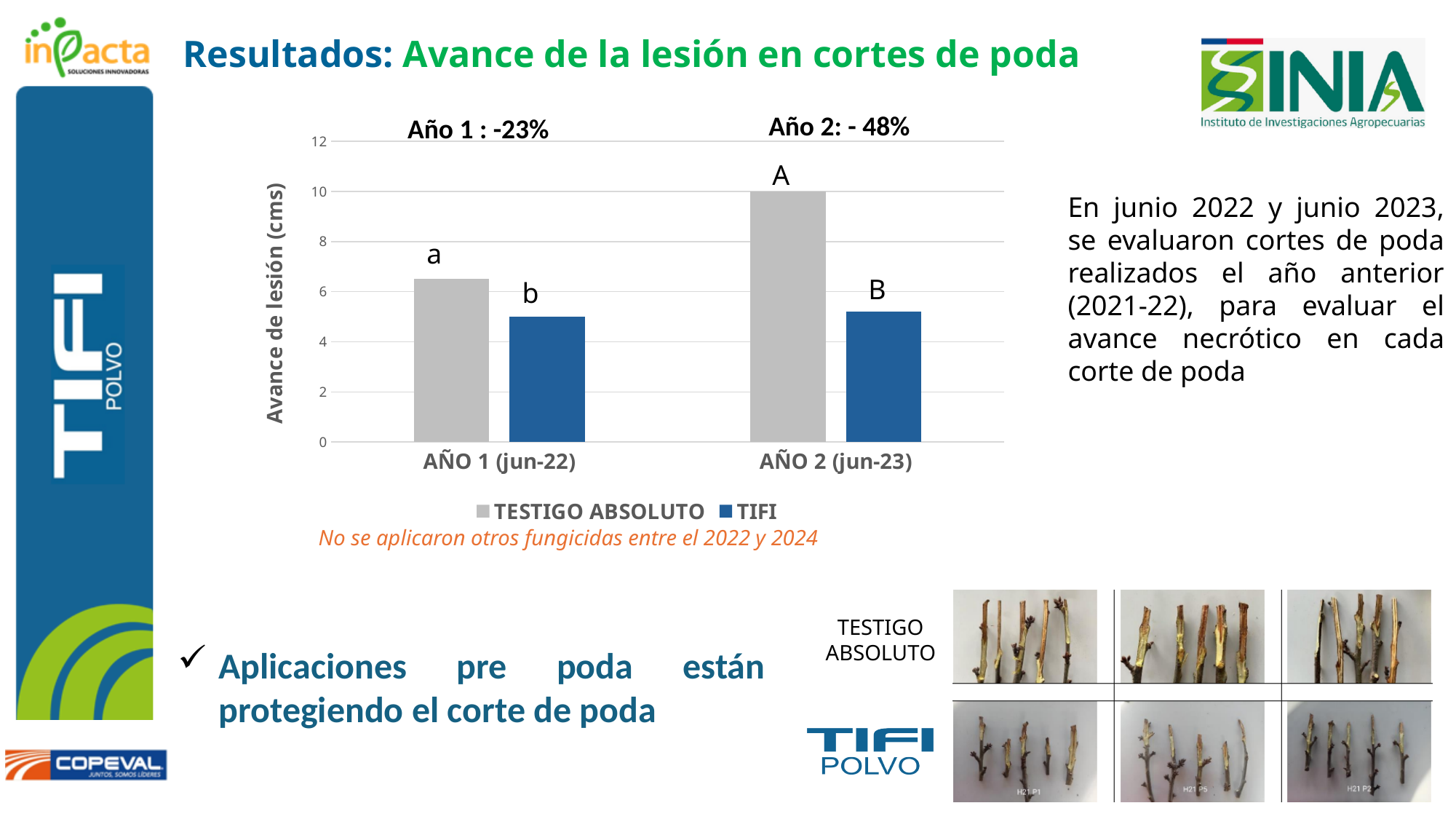
Which bar is the highest in the chart? TESTIGO ABSOLUTO in AÑO 2 (jun-23) Is the value for TIFI in AÑO 2 (jun-23) greater or less than 6? less How many categories are shown on the x axis of the chart? 2 Does the TESTIGO ABSOLUTO value rise or fall from AÑO 1 (jun-22) to AÑO 2 (jun-23)? rise In AÑO 1 (jun-22), which series has the larger value, TESTIGO ABSOLUTO or TIFI? TESTIGO ABSOLUTO What is the value of TESTIGO ABSOLUTO for AÑO 2 (jun-23)? 10 What are the two series named in the chart legend? TESTIGO ABSOLUTO and TIFI How many series does the chart legend list? 2 What kind of chart is shown on the slide? bar chart Is the value for TESTIGO ABSOLUTO in AÑO 1 (jun-22) greater or less than 6? greater What is the label of the y axis of the chart? Avance de lesión (cms) In AÑO 2 (jun-23), which series has the smaller value, TESTIGO ABSOLUTO or TIFI? TIFI